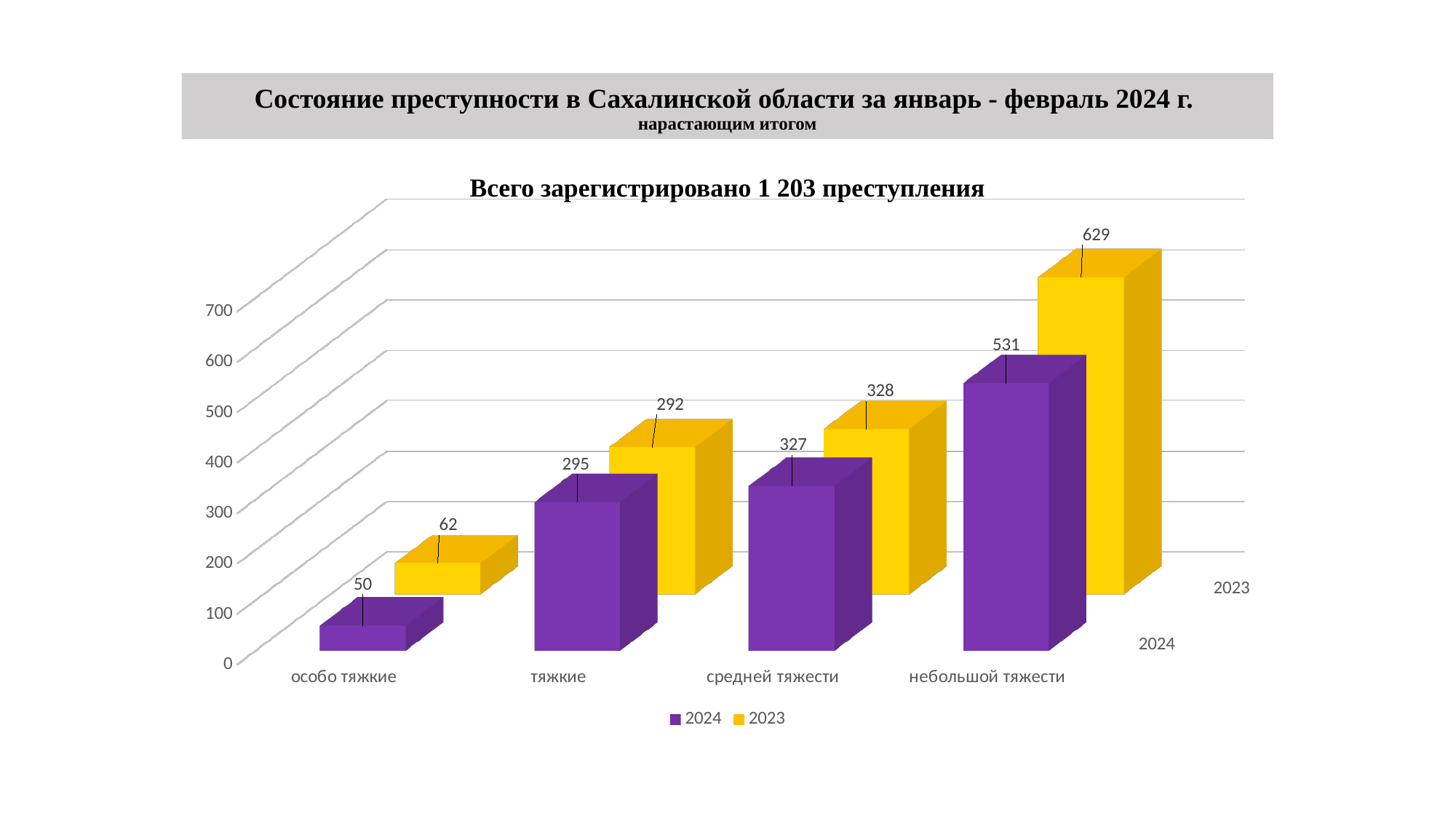
What is the value for 2023 in the 'тяжкие' category? 292 What is the value for 2023 in the 'небольшой тяжести' category? 629 Which category has the lowest value for the 2023 series? особо тяжкие How many categories are shown on the x axis? 4 What is the difference between the 2023 and 2024 values for 'небольшой тяжести'? 98 What is the value for 2024 in the 'особо тяжкие' category? 50 Which is larger for 'тяжкие': the 2024 value or the 2023 value? 2024 Which category has the highest value for the 2024 series? небольшой тяжести What kind of chart is shown on the slide? bar chart What is the value for 2024 in the 'средней тяжести' category? 327 What is the title of the chart? Всего зарегистрировано 1 203 преступления How many series does the legend list? 2